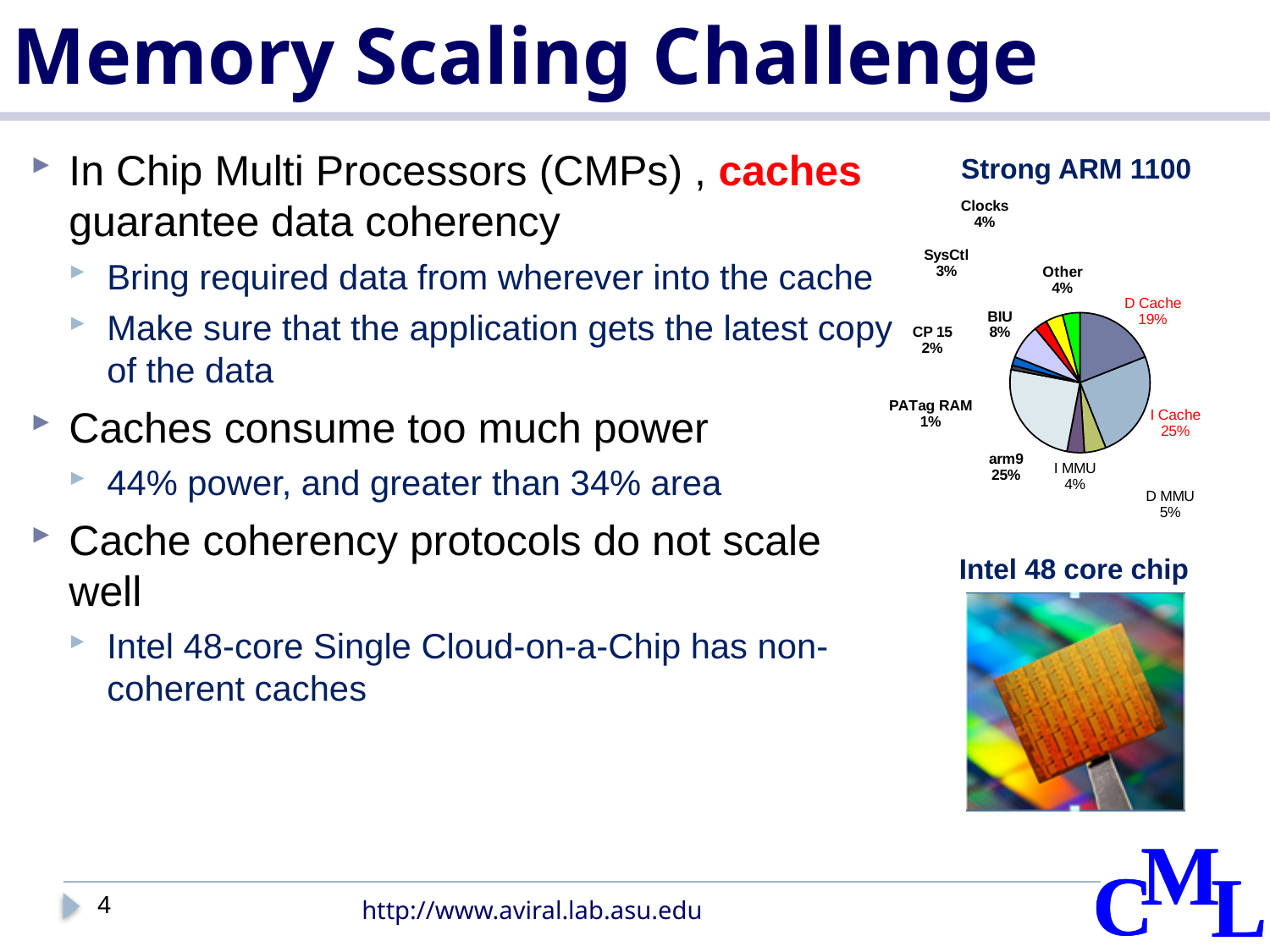
In the Strong ARM 1100 pie chart, what is the difference between the I Cache share and the D Cache share? 6% In the Strong ARM 1100 pie chart, what share does I Cache have? 25% In the Strong ARM 1100 pie chart, which slice has the smallest share? PATag RAM In the Strong ARM 1100 pie chart, how many slices are there? 11 In the Strong ARM 1100 pie chart, which is larger, BIU or SysCtl? BIU In the Strong ARM 1100 pie chart, what share does BIU have? 8% In the Strong ARM 1100 pie chart, what share does D Cache have? 19% In the Strong ARM 1100 pie chart, what share does D MMU have? 5% What type of chart is shown under the title "Strong ARM 1100"? Pie chart In the Strong ARM 1100 pie chart, what share does arm9 have? 25% What is the title of the pie chart on the slide? Strong ARM 1100 In the Strong ARM 1100 pie chart, what is the combined share of D Cache and I Cache? 44%